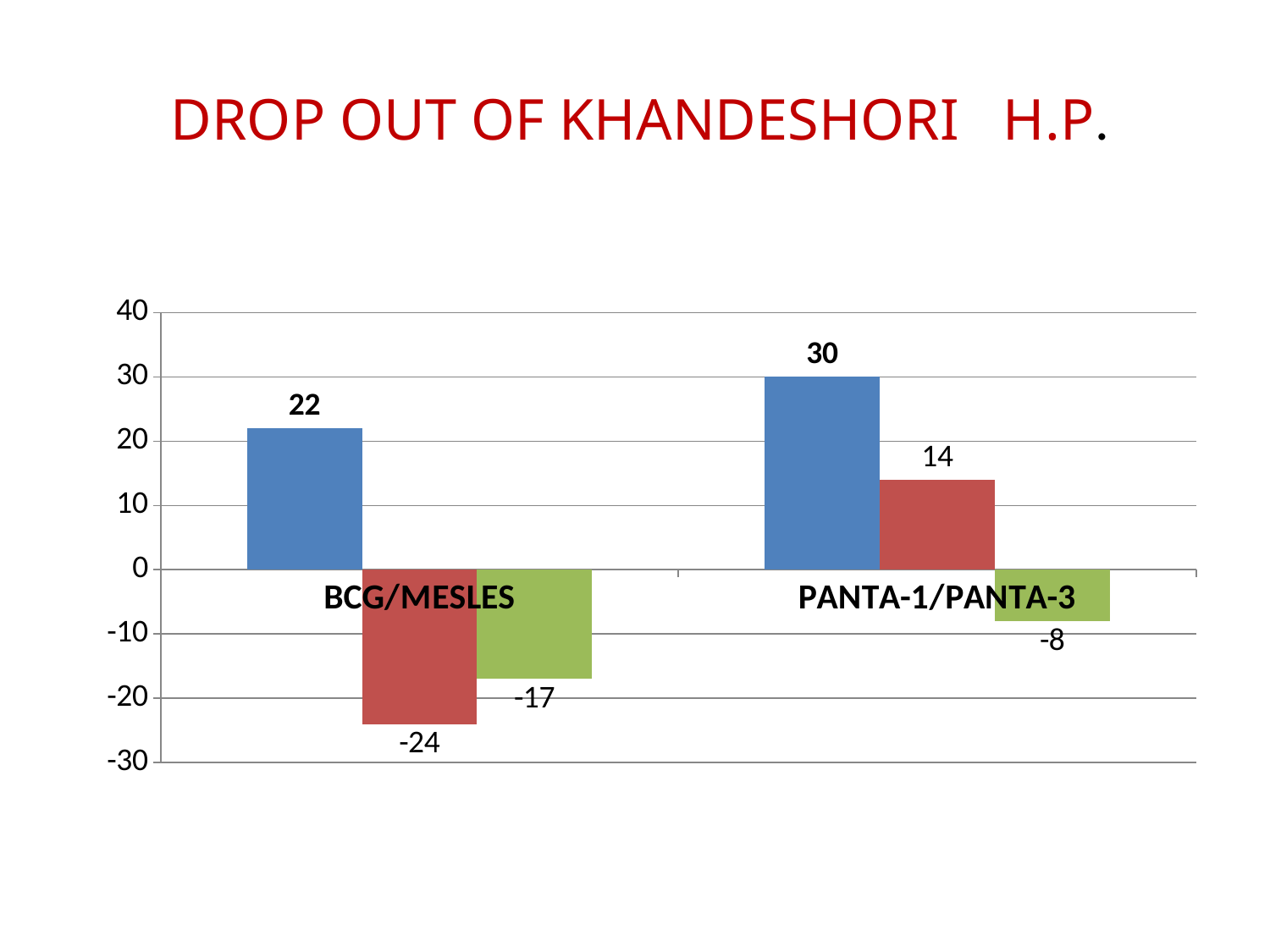
What is the value of the green bar for PANTA-1/PANTA-3? -8 What type of chart is shown on the slide? bar chart What is the value of the red bar for BCG/MESLES? -24 What is the difference between the blue bar values for PANTA-1/PANTA-3 and BCG/MESLES? 8 What is the value of the blue bar for BCG/MESLES? 22 Which bar has the lowest value in the chart? the red bar for BCG/MESLES (-24) What is the title of the slide? DROP OUT OF KHANDESHORI H.P. What is the value of the red bar for PANTA-1/PANTA-3? 14 Which category has the higher blue bar, BCG/MESLES or PANTA-1/PANTA-3? PANTA-1/PANTA-3 How many categories are shown on the x axis? 2 What is the value of the green bar for BCG/MESLES? -17 What is the value of the blue bar for PANTA-1/PANTA-3? 30